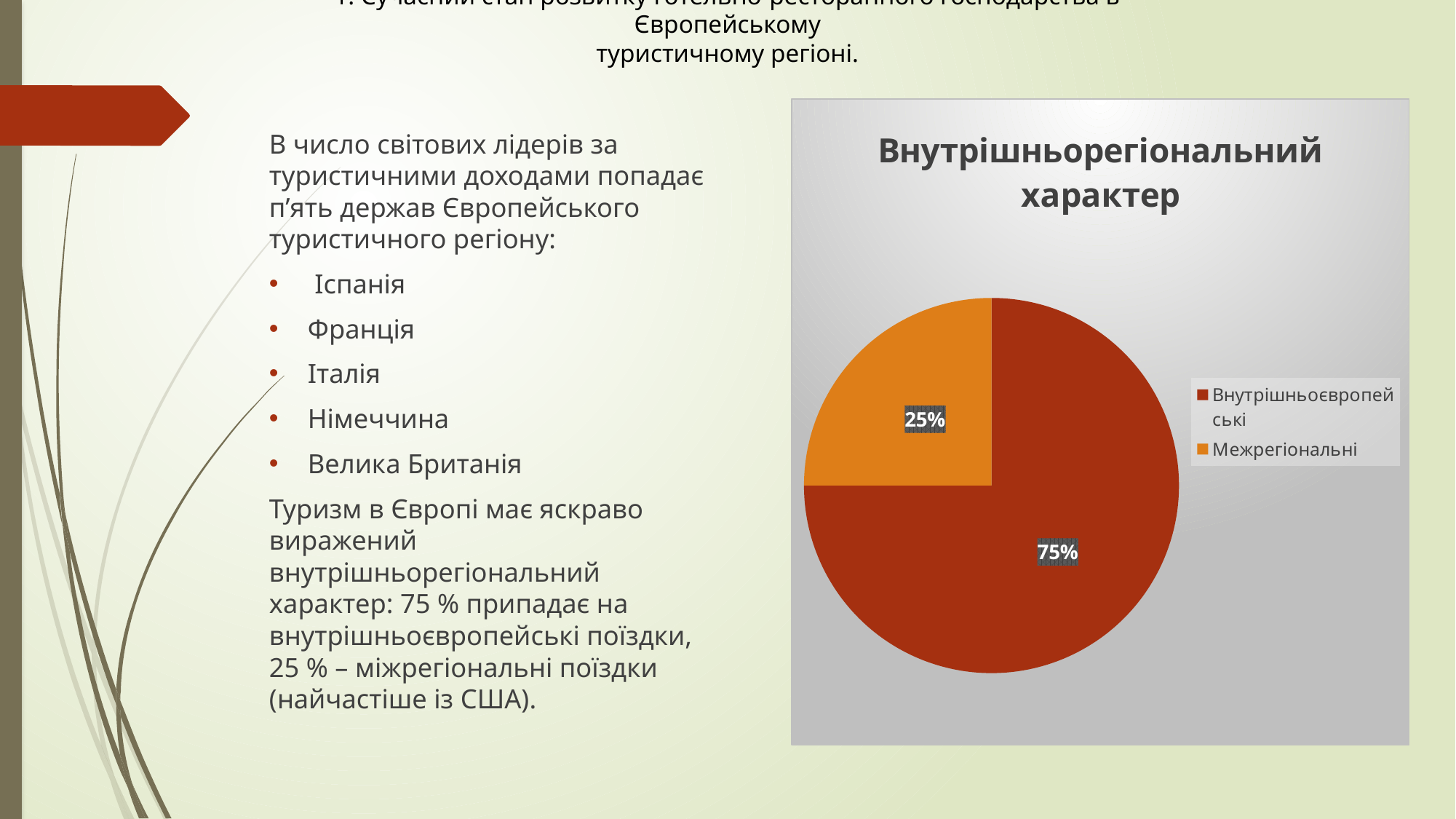
Which slice of the pie is the smallest? Межрегіональні Which is larger: the Внутрішньоєвропейські slice or the Межрегіональні slice? Внутрішньоєвропейські What share of the pie does Межрегіональні represent? 25% What share of the pie does Внутрішньоєвропейські represent? 75% Which slice of the pie is the largest? Внутрішньоєвропейські What type of chart is shown on the slide? pie chart How many slices does the pie chart have? 2 What is the difference in percentage points between the Внутрішньоєвропейські and Межрегіональні slices? 50 What colour is the Межрегіональні slice? orange What is the title of the chart? Внутрішньорегіональний характер How many entries does the legend list? 2